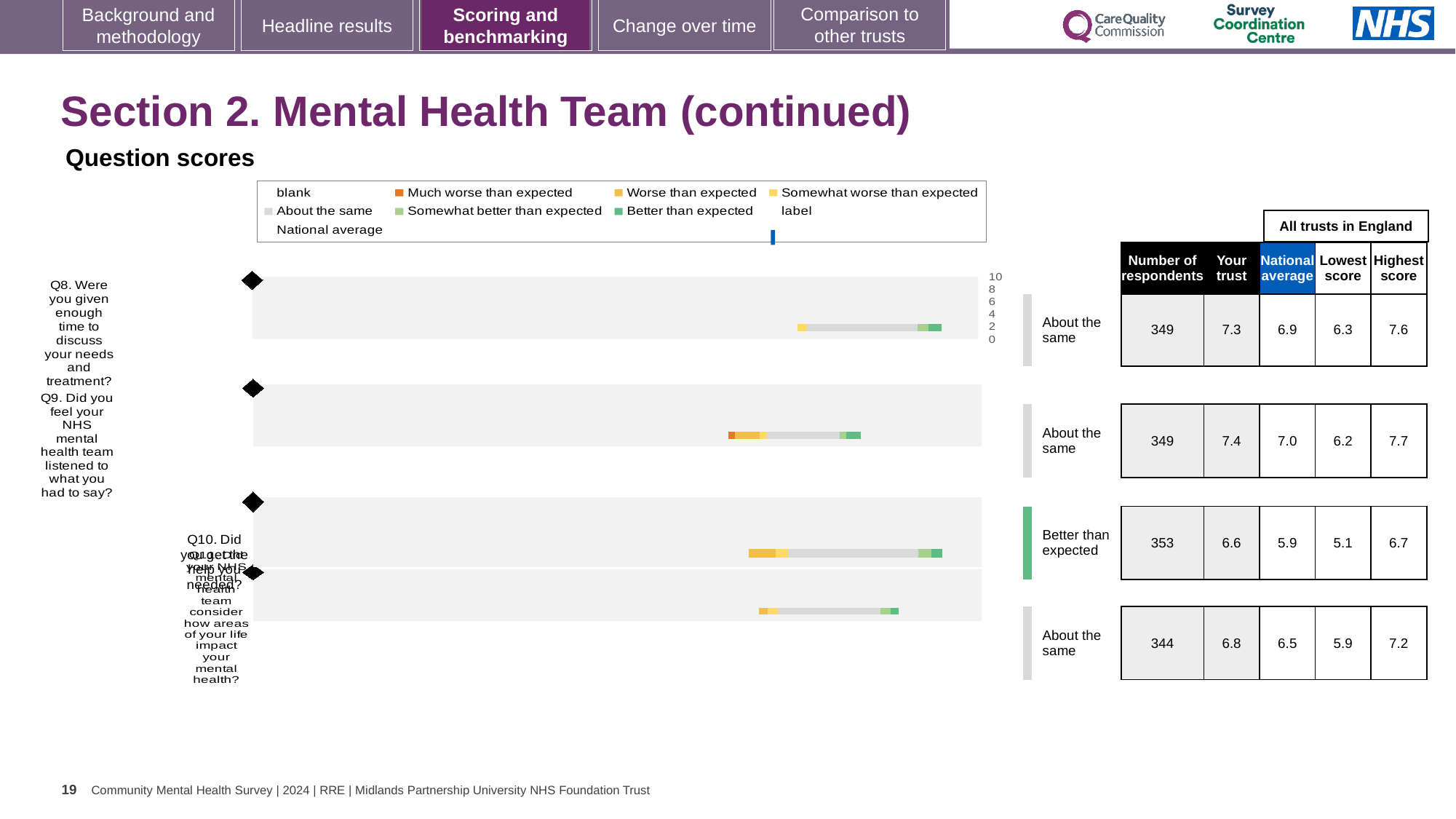
Is the 'Your trust' score for Q9 higher or lower than the national average for Q9? higher How many respondents answered Q10 (Did you get the help you needed?)? 353 What is the 'Your trust' score for Q8 (Were you given enough time to discuss your needs and treatment?)? 7.3 Which question has the lowest national average score? Q10 Which question is rated 'Better than expected' for the trust? Q10 What is the lowest score among all trusts in England for Q10? 5.1 How many questions are plotted in the chart? 4 What is the difference between the 'Your trust' score and the national average for Q10? 0.7 What type of chart is used to show the question scores? bar chart What is the highest score among all trusts in England for Q8? 7.6 What is the national average score for Q9 (Did you feel your NHS mental health team listened to what you had to say?)? 7.0 Which question has the highest 'Your trust' score? Q9